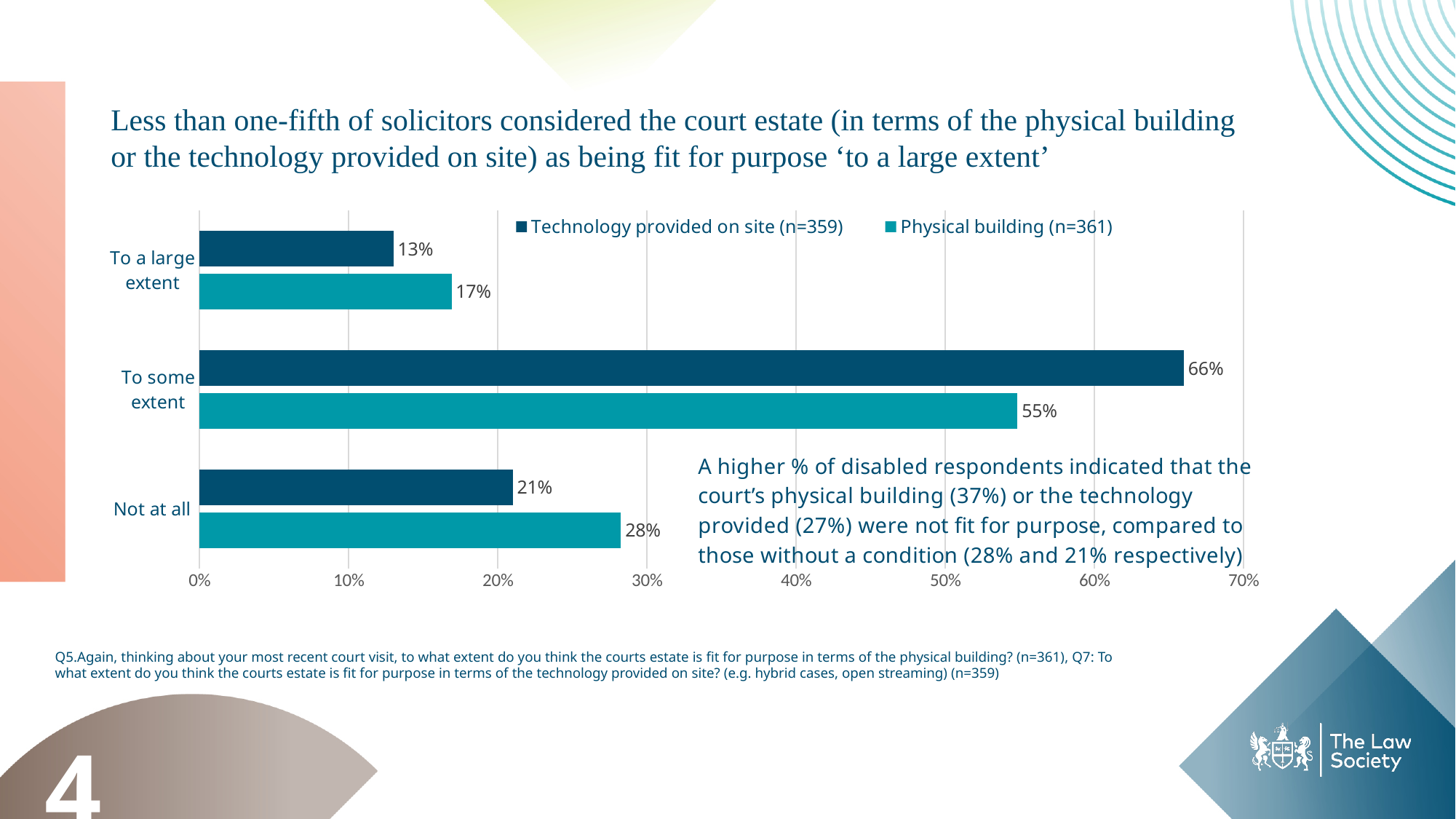
What percentage of respondents said the physical building was fit for purpose 'To some extent'? 55% What is the value for 'Not at all' in the Physical building series? 28% For 'Not at all', which series has the larger value: Technology provided on site or Physical building? Physical building What percentage of respondents said the technology provided on site was fit for purpose 'To a large extent'? 13% Which category has the highest value for the Technology provided on site series? To some extent How many categories are shown on the chart? 3 Is the value for Physical building 'To some extent' greater or less than 50%? greater What is the sample size shown in the legend for the Physical building series? n=361 What is the difference between the Technology provided on site and Physical building values for 'To some extent'? 11 percentage points How many series does the legend list? 2 Which category has the lowest value for the Physical building series? To a large extent What kind of chart is shown on the slide? Bar chart